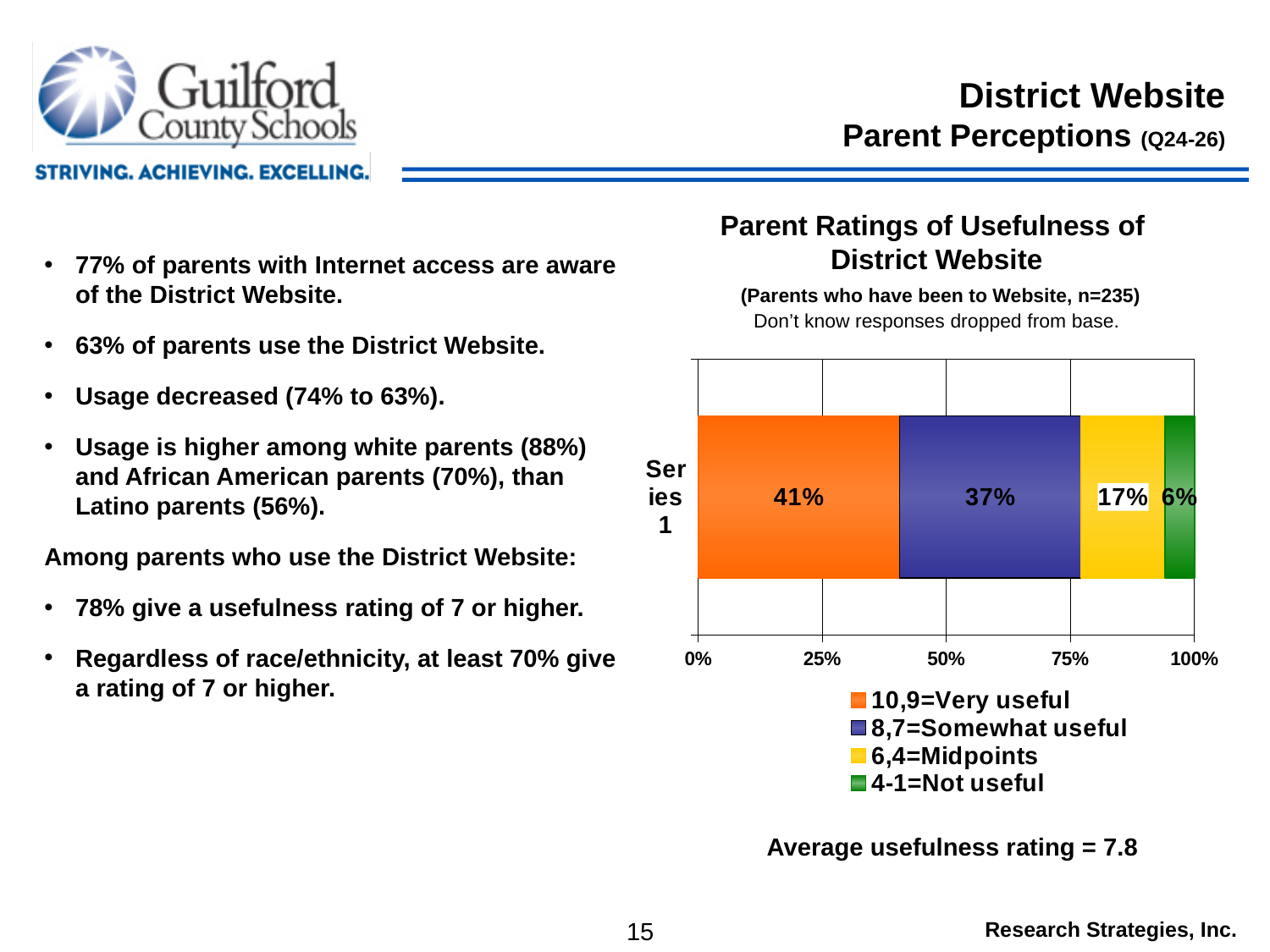
Which rating category has the largest share of the bar? 10,9=Very useful What type of chart is shown on the slide? Stacked bar chart What percentage of parents rated the District Website as Very useful (10,9)? 41% What percentage of parents rated the District Website as Somewhat useful (8,7)? 37% What percentage of parents gave a Midpoints rating (6,4)? 17% What is the difference between the Very useful and Somewhat useful percentages? 4% How many rating categories does the legend list? 4 Which rating category has the smallest share of the bar? 4-1=Not useful Which is larger, the Midpoints share or the Not useful share? Midpoints What is the combined percentage of Very useful and Somewhat useful ratings? 78% What is the sample size (n) stated in the chart subtitle? 235 What percentage of parents rated the District Website as Not useful (4-1)? 6%